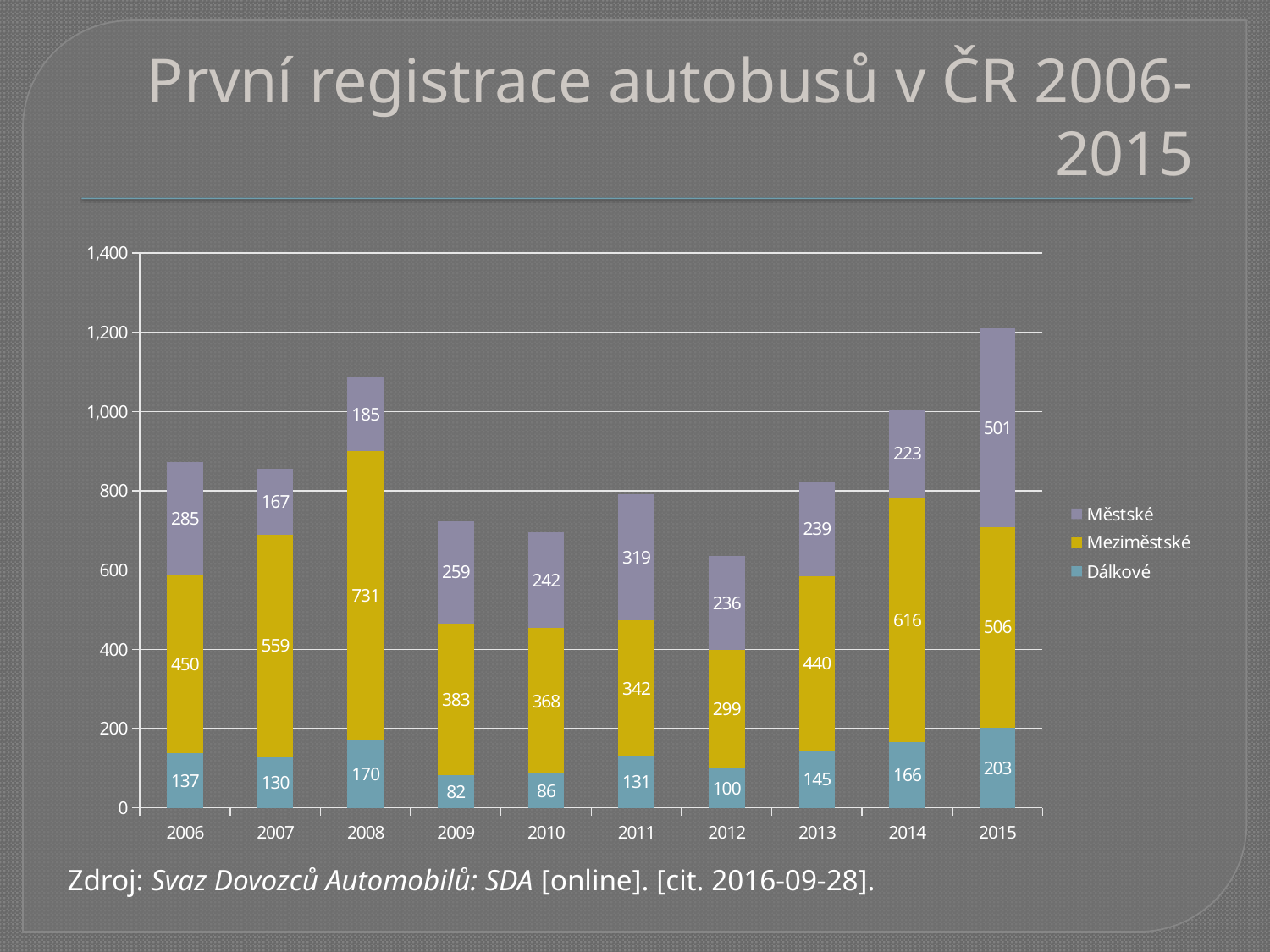
What is the value for Meziměstské in 2008? 731 What is the value for Městské in 2011? 319 Which year has the highest value for Městské? 2015 How many series does the legend list? 3 What is the value for Dálkové in 2015? 203 What is the total of the stacked bar for 2015? 1210 How many years are shown on the x axis? 10 What kind of chart is shown on the slide? Stacked bar chart Which year has the lowest value for Dálkové? 2009 What is the difference between the Meziměstské values for 2014 and 2013? 176 Which is larger: the Městské value for 2006 or for 2009? 2006 Is the total height of the 2012 stacked bar greater or less than 800? less